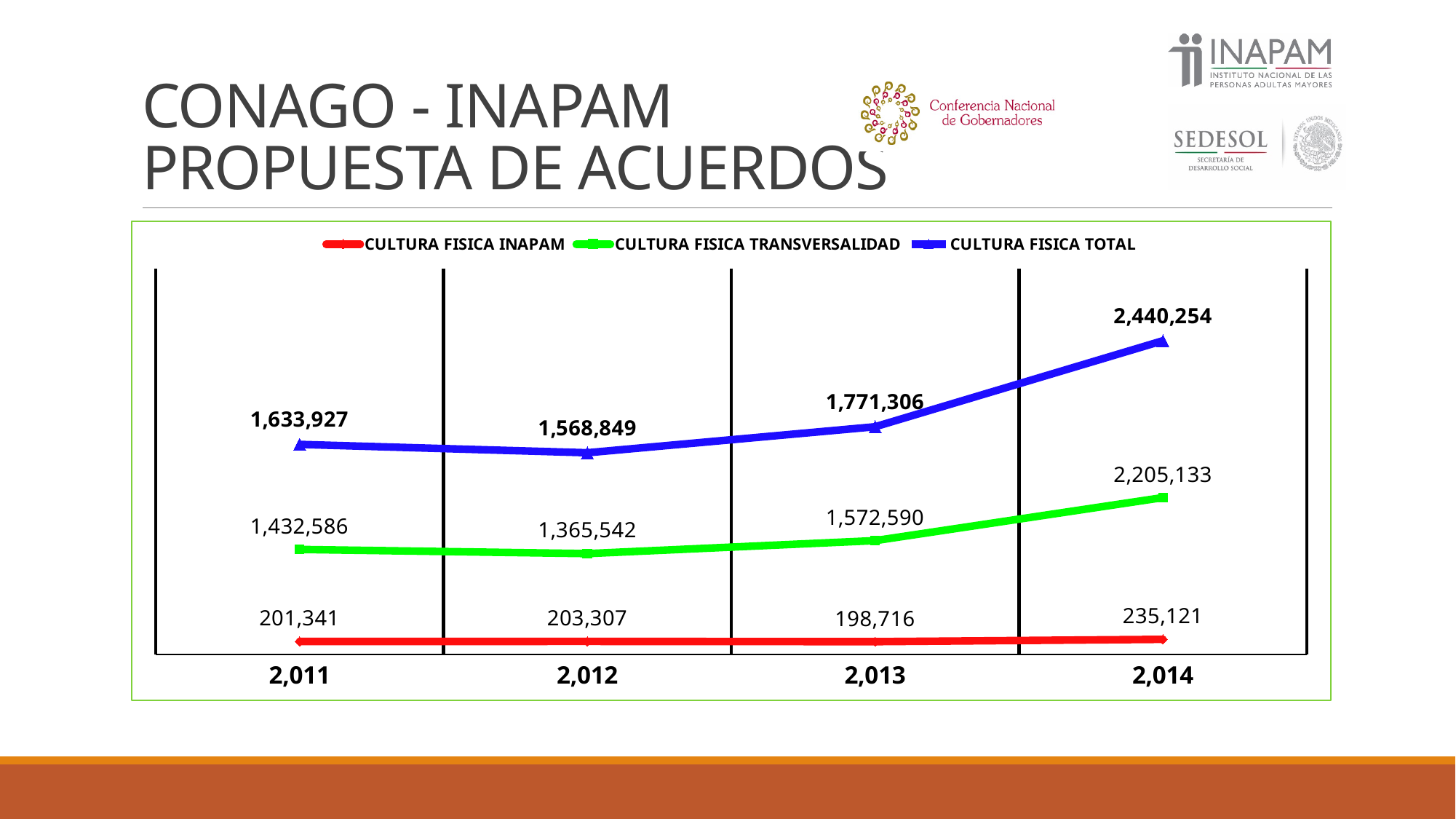
What is the difference between CULTURA FISICA INAPAM in 2,014 and in 2,013? 36,405 In which year is CULTURA FISICA TOTAL highest? 2,014 Which is larger: CULTURA FISICA TRANSVERSALIDAD in 2,011 or in 2,012? 2,011 What is the value of CULTURA FISICA TRANSVERSALIDAD in 2,013? 1,572,590 What is the value of CULTURA FISICA TOTAL in 2,014? 2,440,254 How many series does the legend list? 3 What is the difference between CULTURA FISICA TOTAL in 2,014 and in 2,013? 668,948 What is the value of CULTURA FISICA INAPAM in 2,011? 201,341 What kind of chart is shown on the slide? Line chart How many years are shown on the x axis? 4 Which colour is used for the CULTURA FISICA TOTAL line? Blue In which year is CULTURA FISICA INAPAM lowest? 2,013